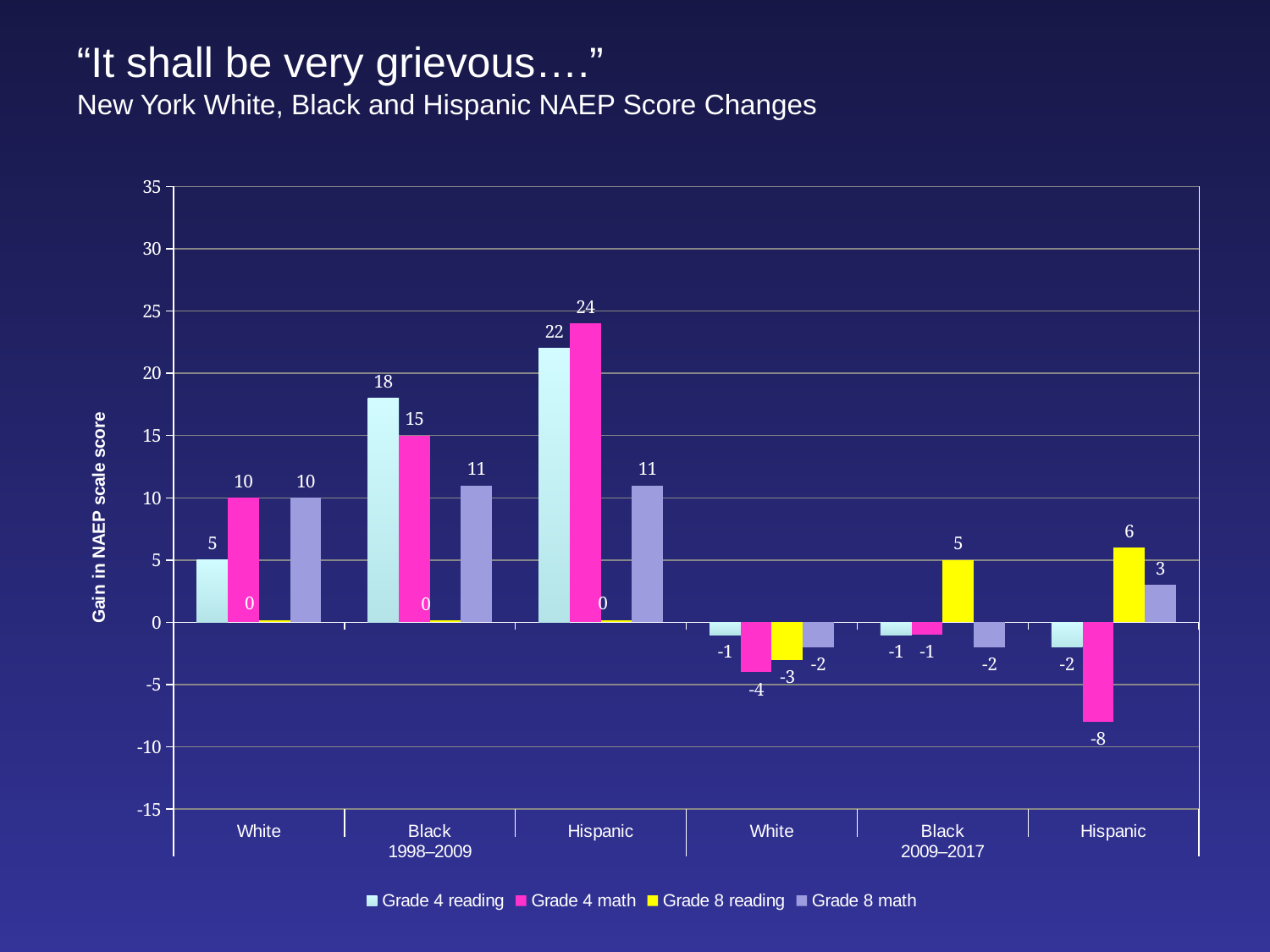
What is the Grade 8 math value for Hispanic students in 2009–2017? 3 Which bar has the highest value on the chart? Grade 4 math for Hispanic, 1998–2009 (24) What is the title of the vertical axis? Gain in NAEP scale score What is the Grade 4 math value for Hispanic students in 2009–2017? -8 What kind of chart is shown on the slide? Bar chart What is the Grade 8 reading value for Black students in 2009–2017? 5 Which bar has the lowest value on the chart? Grade 4 math for Hispanic, 2009–2017 (-8) How many series does the legend list? 4 How much larger is the Grade 4 reading gain for Black students than for White students in 1998–2009? 13 For Black students in 1998–2009, which is larger: Grade 4 reading or Grade 4 math? Grade 4 reading How many category groups are shown along the x axis? 6 What is the Grade 4 math value for Hispanic students in 1998–2009? 24